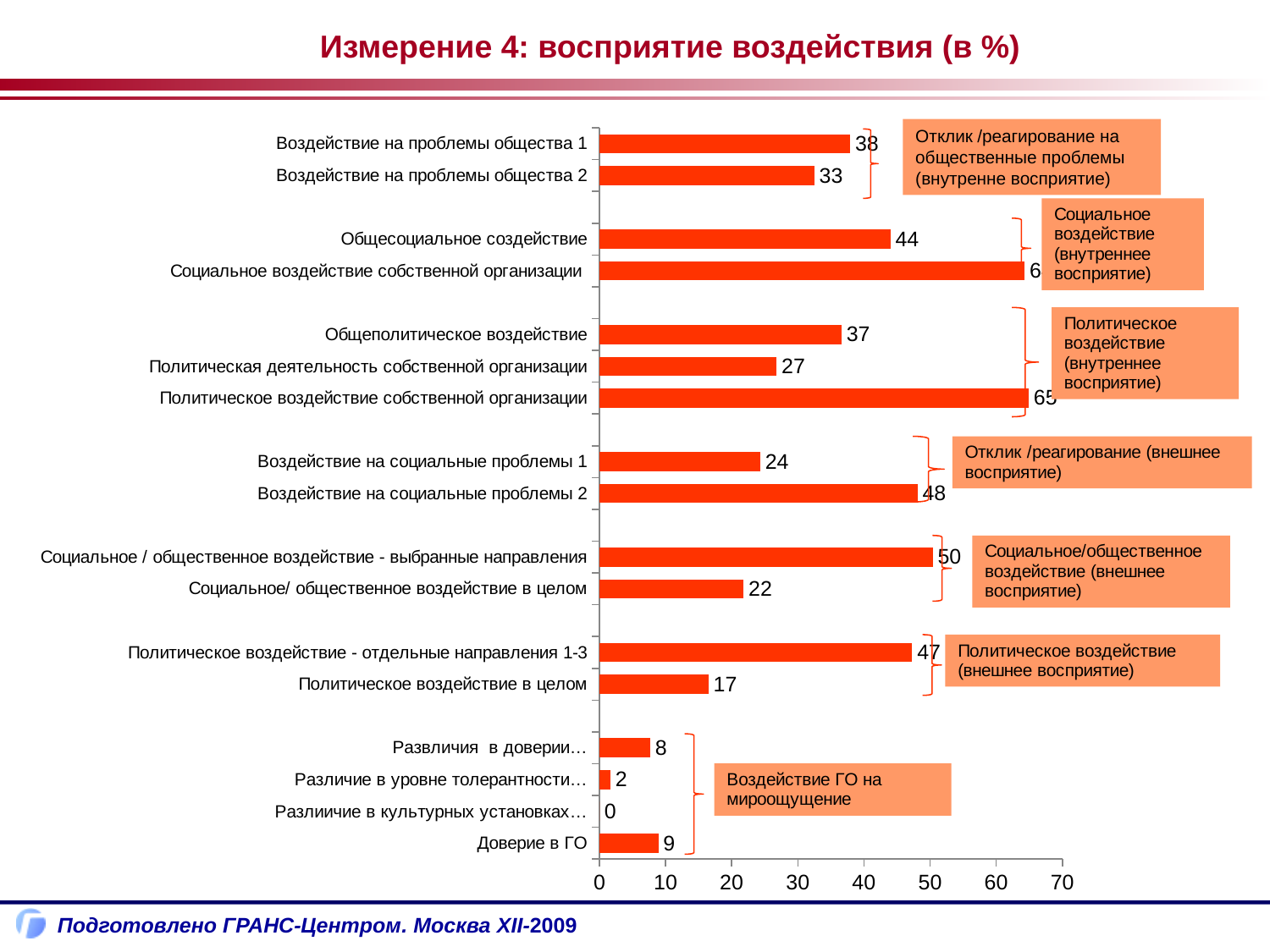
What is the title of the slide? Измерение 4: восприятие воздействия (в %) What is the value for "Политическое воздействие собственной организации"? 65 What is the value for "Воздействие на проблемы общества 1"? 38 What is the difference between "Воздействие на социальные проблемы 2" and "Воздействие на социальные проблемы 1"? 24 What is the value for "Социальное/ общественное воздействие в целом"? 22 What kind of chart is shown on the slide? bar chart Which category has the lowest value? Разлиичие в культурных установках… What is the difference between "Политическое воздействие - отдельные направления 1-3" and "Политическое воздействие в целом"? 30 What is the value for "Доверие в ГО"? 9 Is the value for "Социальное воздействие собственной организации" greater or less than 60? greater Which is larger: "Общесоциальное создействие" or "Общеполитическое воздействие"? Общесоциальное создействие How many categories are plotted in the chart? 17